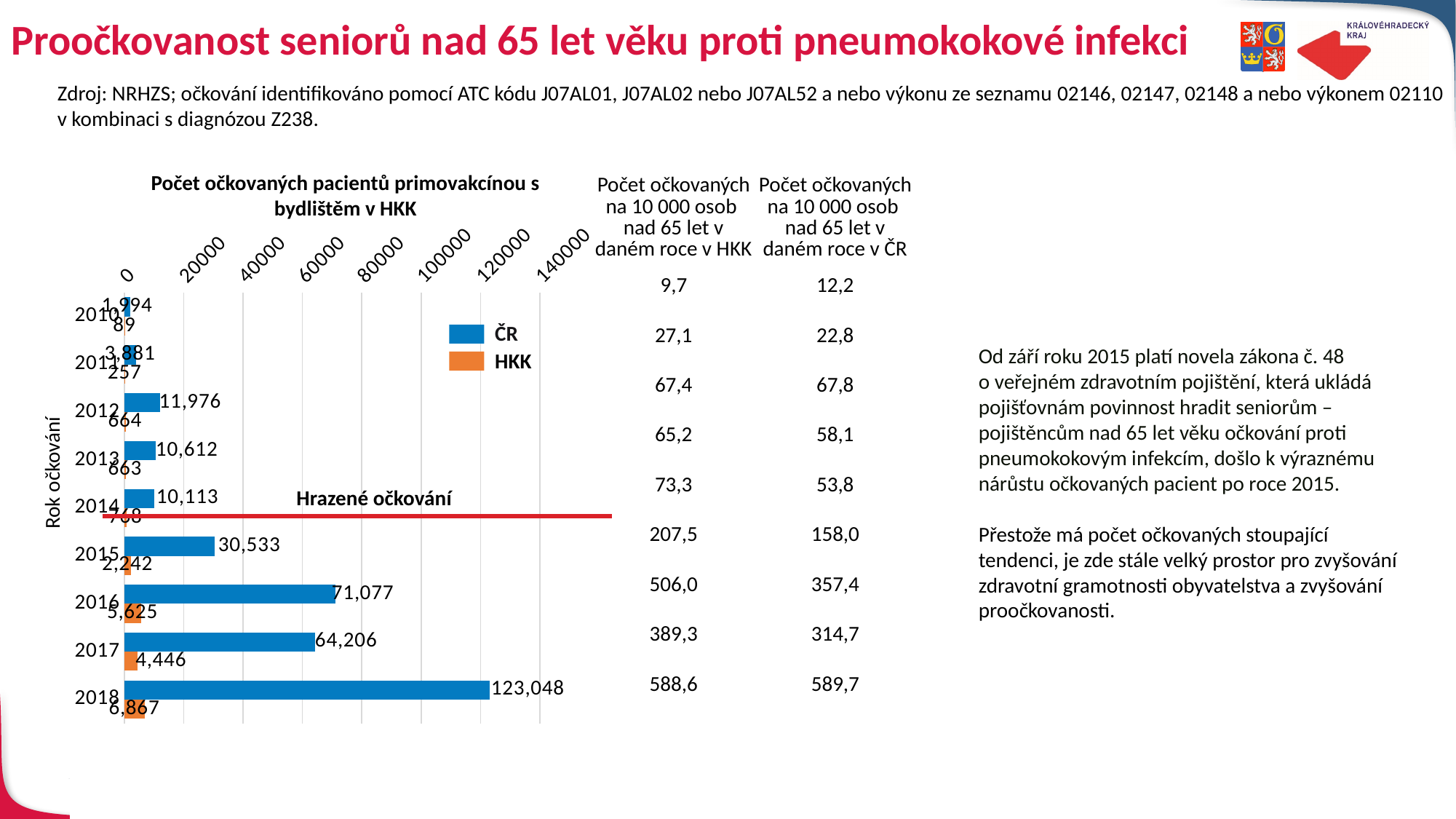
How many series does the chart legend list? 2 Which year has the lowest HKK value? 2010 Which year has the highest ČR value? 2018 What kind of chart is shown on the slide? bar chart What label is written above the red horizontal line on the chart? Hrazené očkování What is the ČR value for 2015? 30,533 Which is larger, the HKK value for 2016 or for 2018? 2018 How many years are plotted on the chart? 9 What is the difference between the ČR values for 2016 and 2017? 6,871 What is the HKK value for 2017? 4,446 What is the ČR value for 2018? 123,048 Is the ČR value for 2016 greater or less than 60000? greater